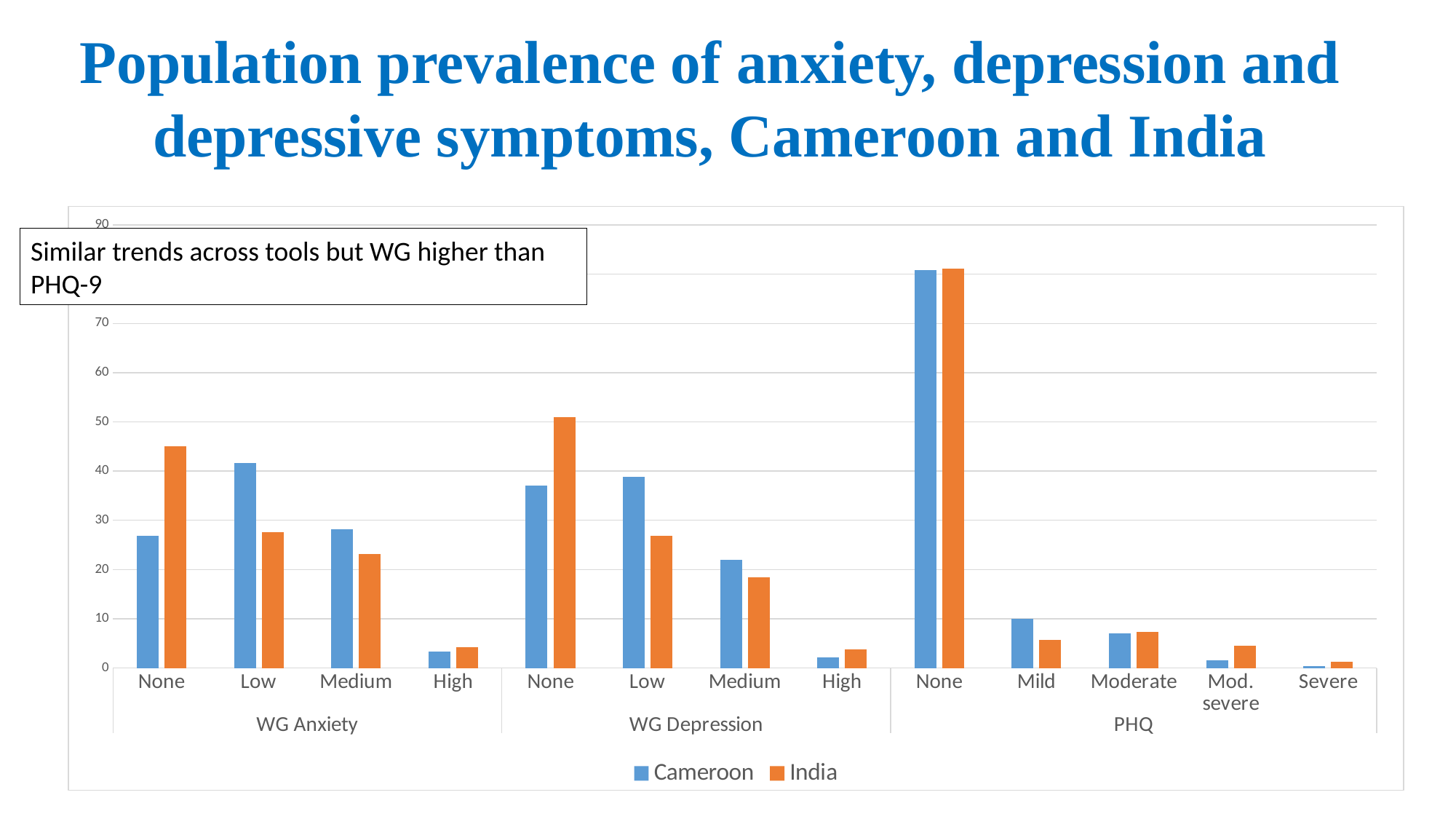
How many categories are shown along the x axis in total? 13 Which two series are listed in the legend? Cameroon and India Which is larger under PHQ Mild, Cameroon or India? Cameroon Is the value for India under WG Anxiety None greater or less than 40? greater Which category has the lowest value for Cameroon? PHQ Severe What kind of chart is shown on the slide? bar chart How many series does the legend list? 2 Is the value for Cameroon under WG Depression None greater or less than 40? less Which category has the highest value for India? PHQ None Which is larger under WG Anxiety Low, Cameroon or India? Cameroon